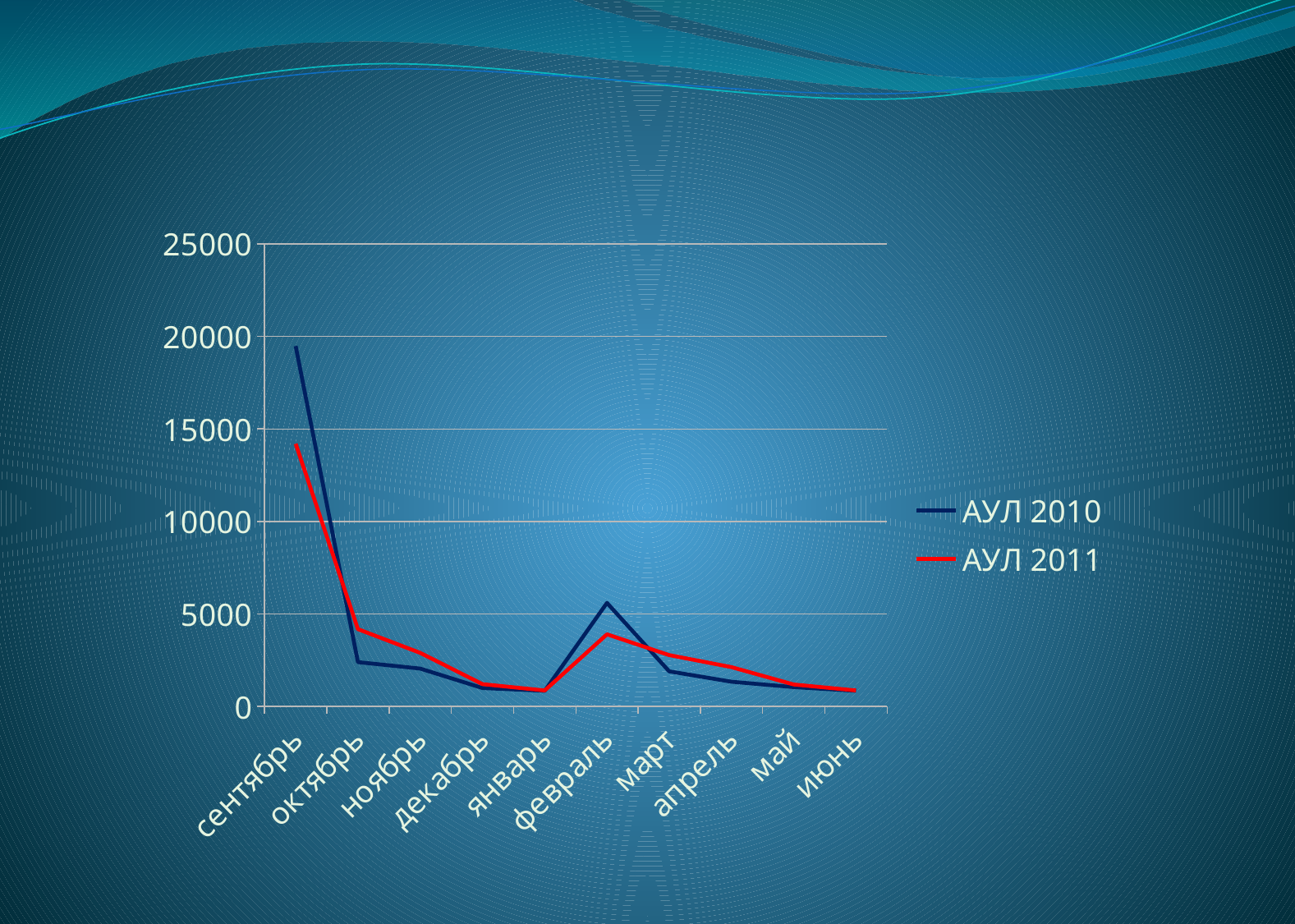
Is the value for АУЛ 2011 in сентябрь greater or less than 15000? less In октябрь, which series has the larger value, АУЛ 2010 or АУЛ 2011? АУЛ 2011 In сентябрь, which series has the larger value, АУЛ 2010 or АУЛ 2011? АУЛ 2010 How many months are shown along the x axis? 10 Which month has the highest value for АУЛ 2010? сентябрь Which month has the highest value for АУЛ 2011? сентябрь Is the value for АУЛ 2010 in сентябрь greater or less than 15000? greater What kind of chart is shown on the slide? line chart What colour is the line for АУЛ 2011? red How many series does the legend list? 2 Is the value for АУЛ 2011 in февраль greater or less than 5000? less